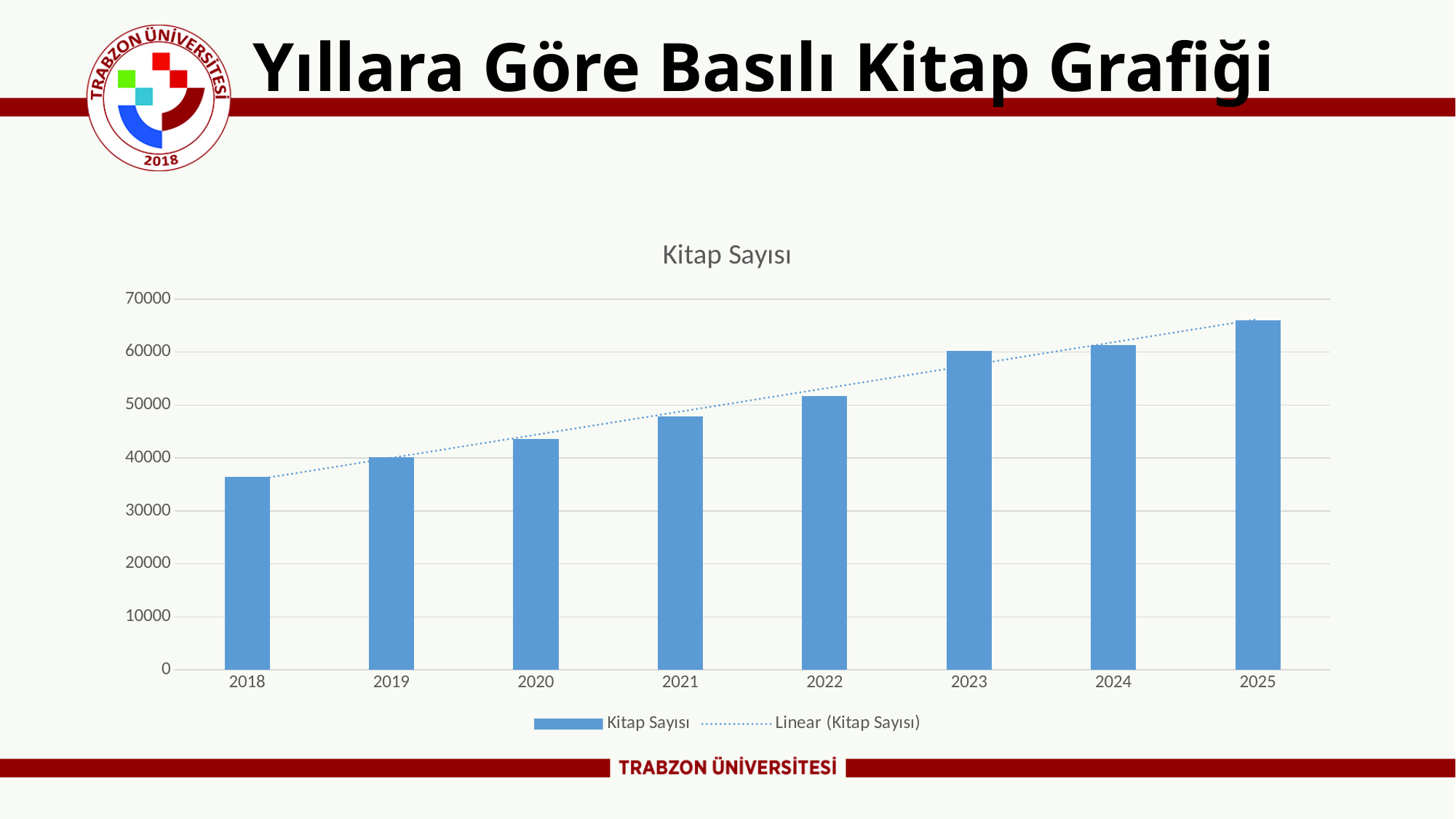
What is the name of the dotted line series in the legend? Linear (Kitap Sayısı) Which year has the highest Kitap Sayısı value? 2025 What is the title of the chart? Kitap Sayısı Which is larger, the value for 2022 or the value for 2024? 2024 What kind of chart is shown on the slide? bar chart Do the Kitap Sayısı values rise or fall from 2018 to 2025? rise Is the value for 2018 greater or less than 40000? less Is the value for 2021 greater or less than 50000? less Which year has the lowest Kitap Sayısı value? 2018 Is the value for 2025 greater or less than 60000? greater How many years are shown on the x axis of the chart? 8 How many entries does the chart's legend list? 2